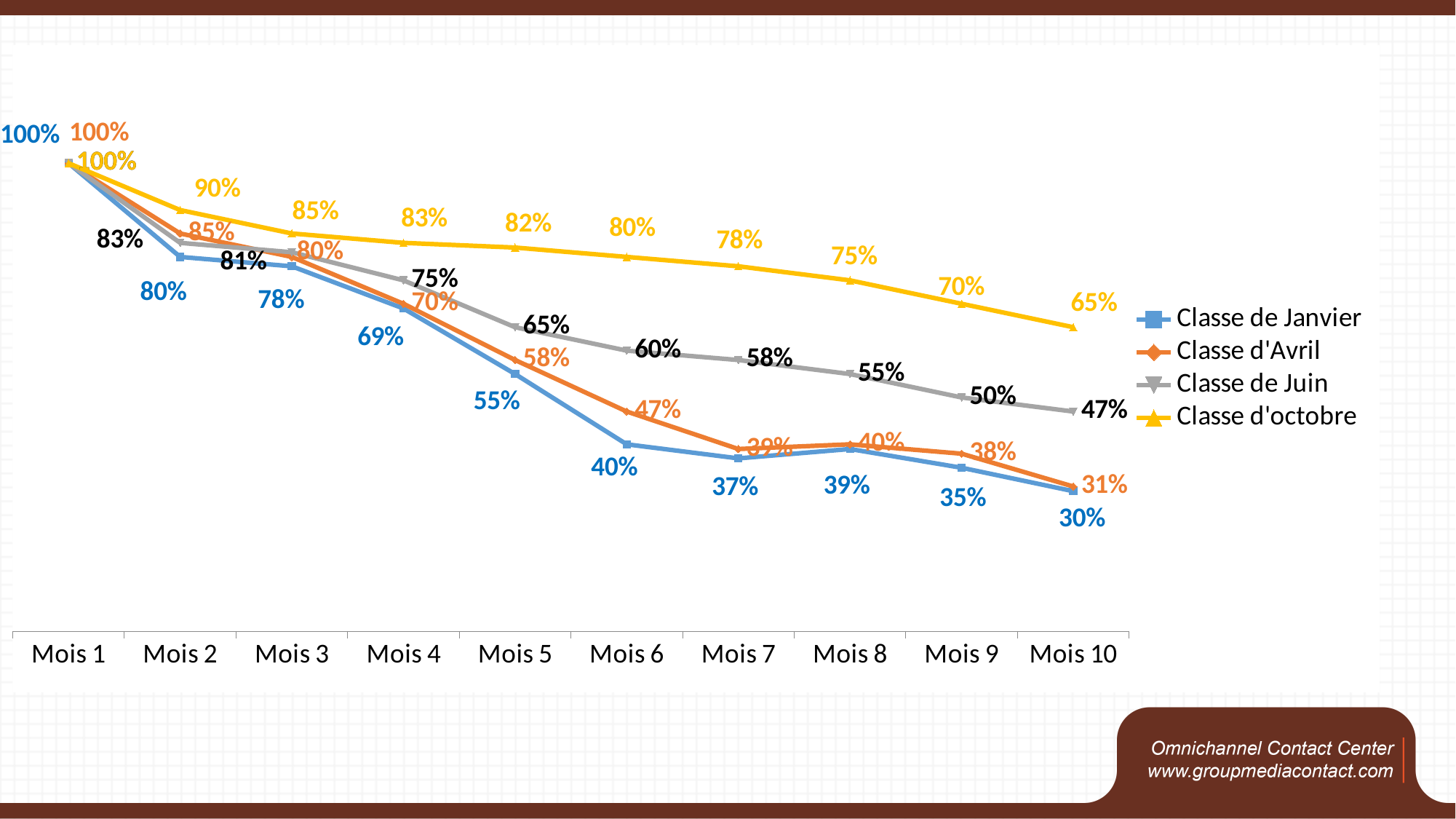
What is the difference between Classe d'octobre and Classe de Janvier at Mois 10? 35% How many months (categories) are shown on the x axis? 10 What is the value for Classe de Juin at Mois 7? 58% What kind of chart is shown on the slide? Line chart How many series does the legend list? 4 What is the value for Classe d'Avril at Mois 6? 47% Which is larger at Mois 4: Classe de Juin or Classe d'Avril? Classe de Juin Do the values for Classe d'octobre rise or fall from Mois 1 to Mois 10? Fall What is the value for Classe d'octobre at Mois 5? 82% What is the value for Classe de Janvier at Mois 10? 30% Which series has the lowest value at Mois 5? Classe de Janvier Which series has the highest value at Mois 10? Classe d'octobre